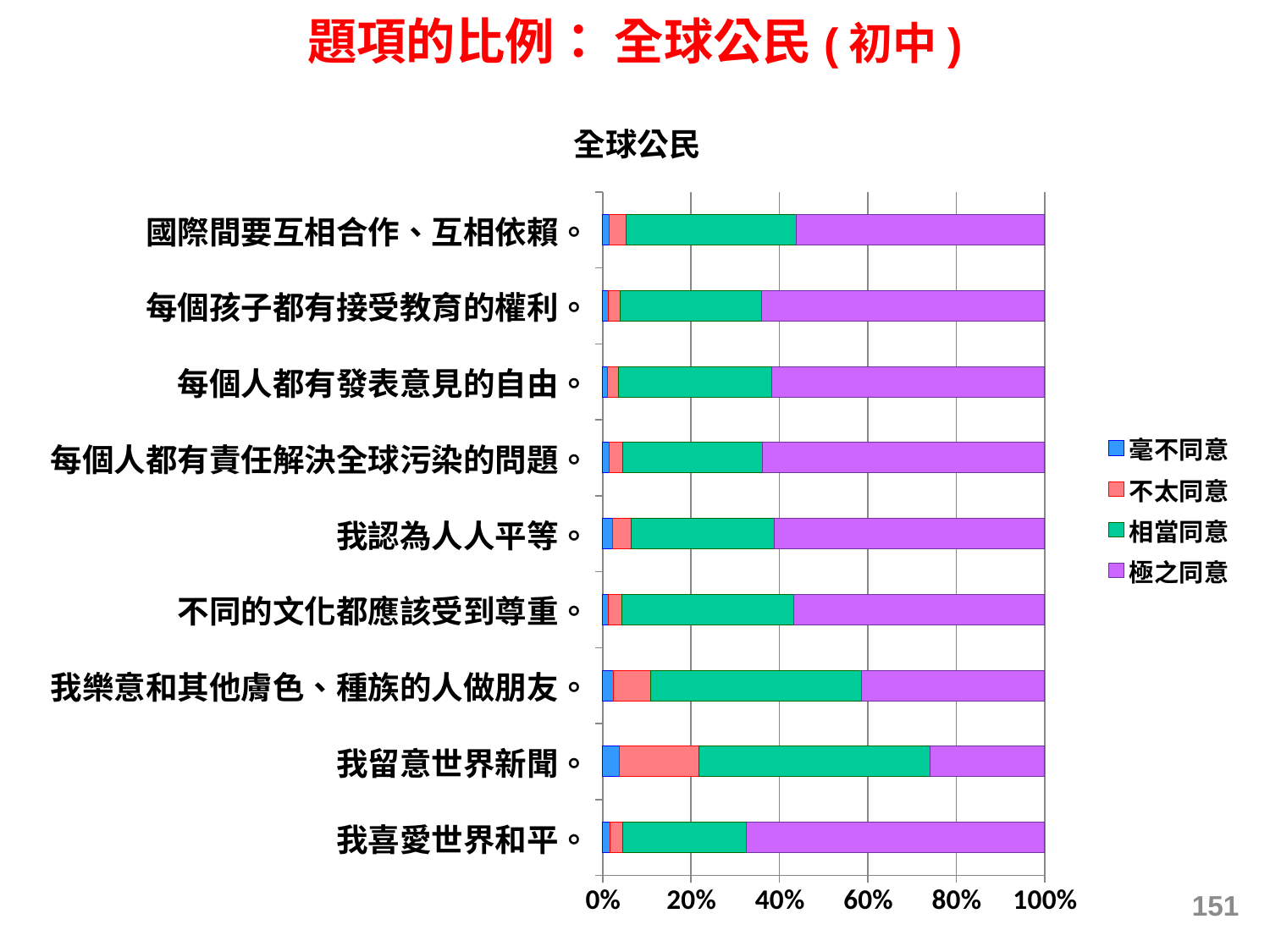
How many series does the legend list? 4 Which item has the smallest 極之同意 share? 我留意世界新聞。 What is the title shown above the chart? 全球公民 Is the 極之同意 share for 我喜愛世界和平。 greater or less than 60%? greater How many items (categories) are plotted in the chart? 9 Is the 極之同意 share for 國際間要互相合作、互相依賴。 greater or less than 40%? greater What kind of chart is shown on the slide? stacked bar chart Which has the larger 極之同意 share: 我留意世界新聞。 or 我喜愛世界和平。? 我喜愛世界和平。 Which has the larger 相當同意 share: 我留意世界新聞。 or 我喜愛世界和平。? 我留意世界新聞。 Is the 極之同意 share for 我留意世界新聞。 greater or less than 40%? less Which legend entry is shown in purple? 極之同意 Which item has the largest 不太同意 share? 我留意世界新聞。